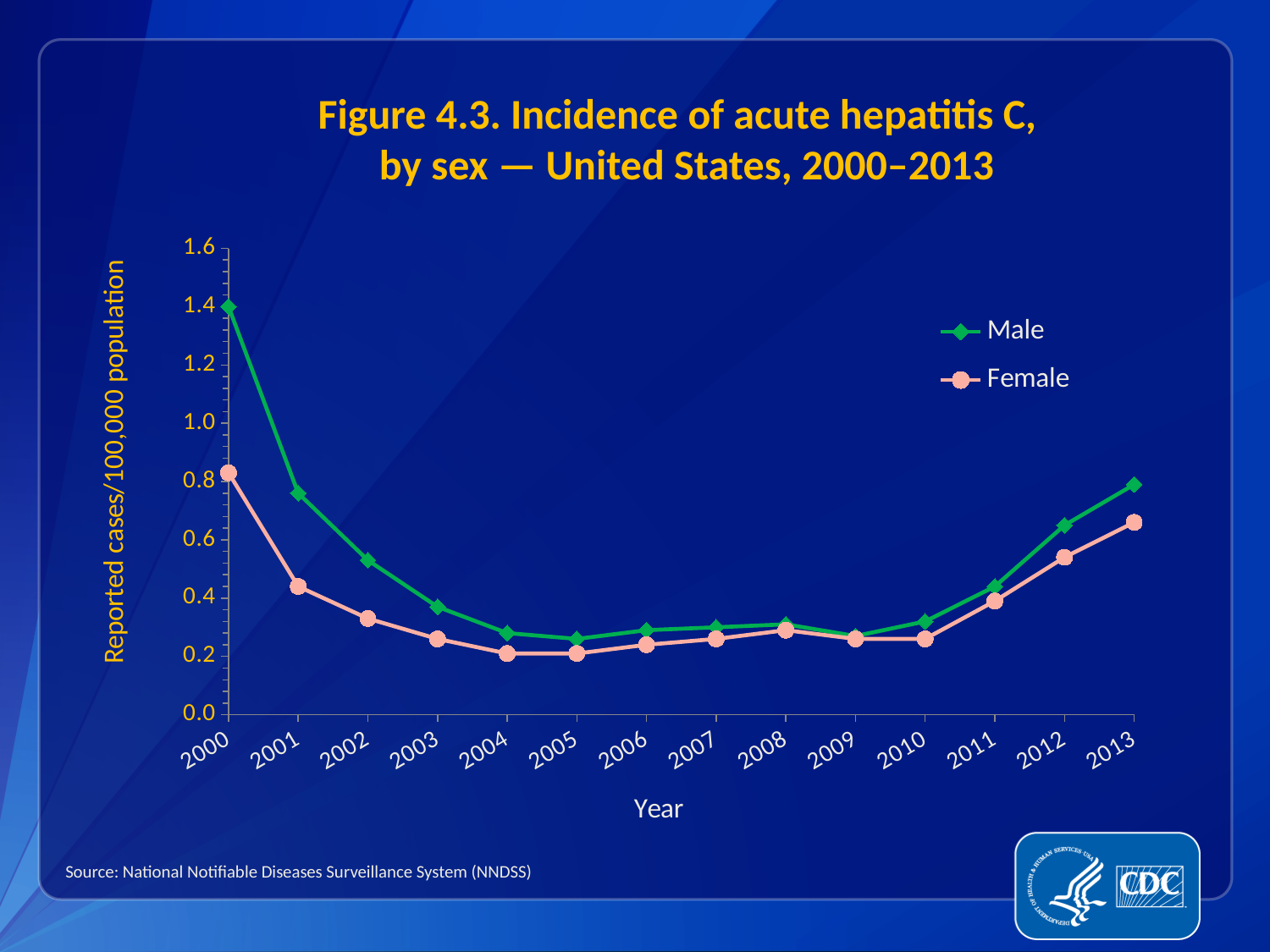
Is the Male value for 2004 greater or less than 0.4? less Do the Female values rise or fall from 2010 to 2013? Rise Is the Female value for 2000 greater or less than 0.6? greater How many years are plotted along the x axis? 14 Is the Female value for 2013 greater or less than 0.8? less What kind of chart is shown on the slide? Line chart How many series does the legend list? 2 In which year is the Male incidence rate highest? 2000 Do the Male values rise or fall from 2000 to 2005? Fall In 2013, which series has the larger value, Male or Female? Male In which year is the Female incidence rate highest? 2000